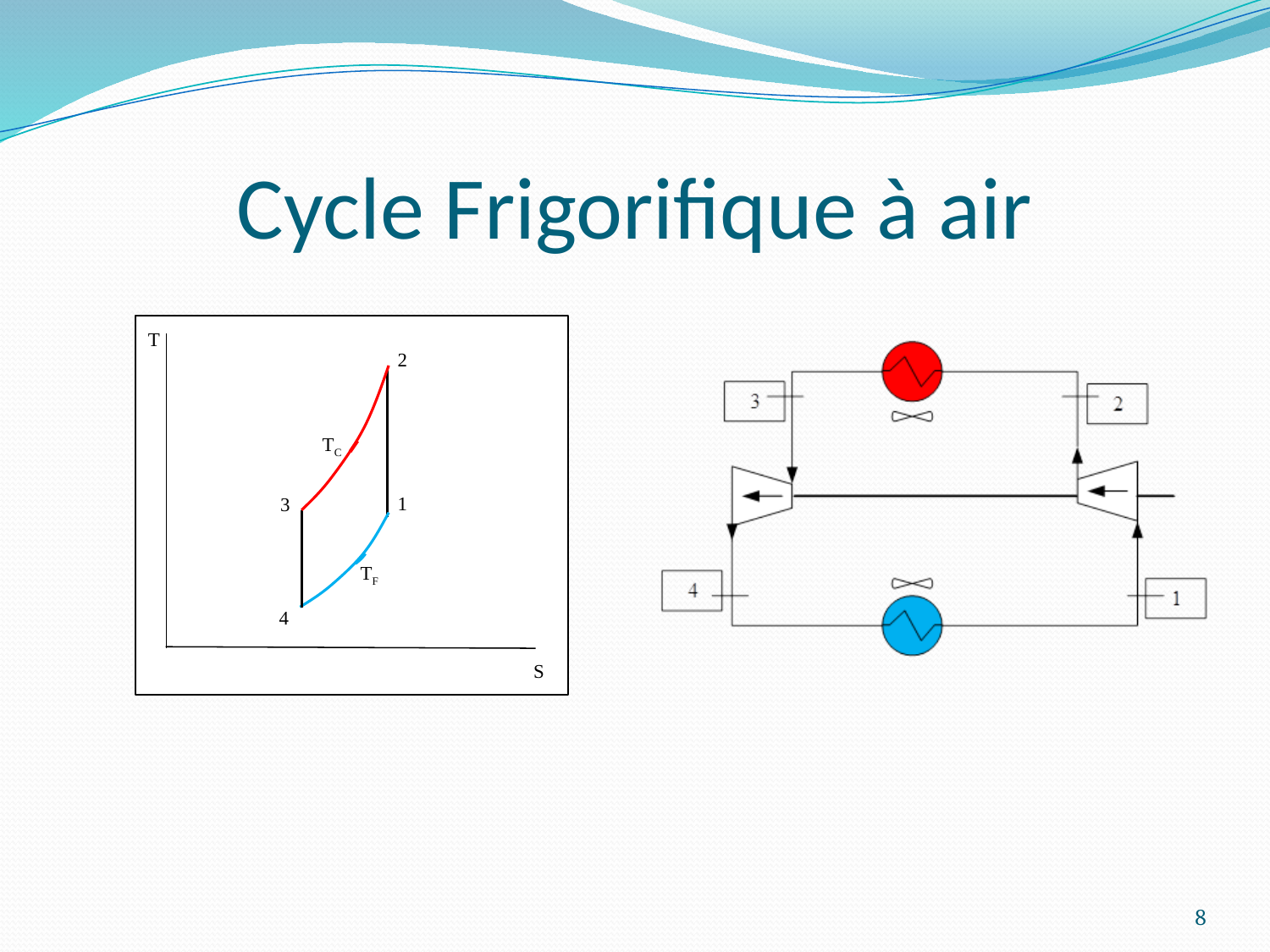
On the T-S diagram, which point has the larger entropy S, point 2 or point 3? 2 On the T-S diagram, does the temperature rise or fall along the curve from point 2 to point 3? fall On the T-S diagram, which point is at a higher temperature, point 2 or point 3? 2 On the T-S diagram, what is the label of the vertical axis? T On the T-S diagram, which point is at a higher temperature, point 1 or point 4? 1 On the T-S diagram, does the temperature rise or fall along the curve from point 4 to point 1? rise On the T-S diagram, which numbered point is at the highest temperature? 2 On the T-S diagram, which numbered point is at the lowest temperature? 4 On the T-S diagram, how many numbered state points are plotted? 4 On the T-S diagram, what is the label of the horizontal axis? S